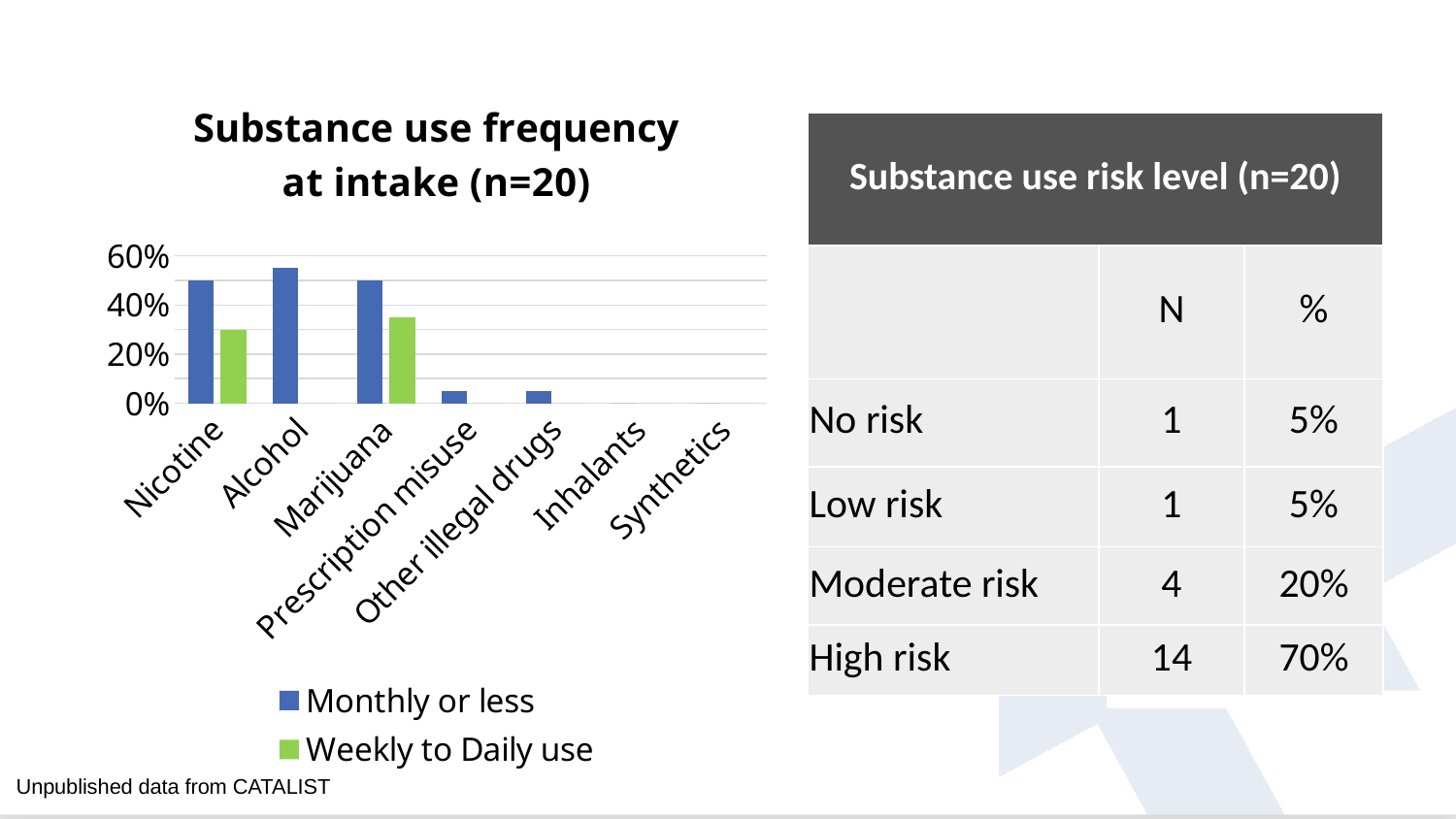
Is the 'Monthly or less' value for Nicotine greater or less than 40%? greater How many substance categories are shown on the x axis of the chart? 7 Is the 'Monthly or less' value for Prescription misuse greater or less than 20%? less What is the title of the chart? Substance use frequency at intake (n=20) Which substance has the highest 'Monthly or less' value in the chart? Alcohol Which substance has the highest 'Weekly to Daily use' value in the chart? Marijuana What kind of chart is shown on the slide? bar chart Is the 'Weekly to Daily use' value for Marijuana greater or less than 40%? less For Nicotine, which is larger: the 'Monthly or less' value or the 'Weekly to Daily use' value? Monthly or less How many series does the chart's legend list? 2 Which colour represents the 'Weekly to Daily use' series in the chart? green